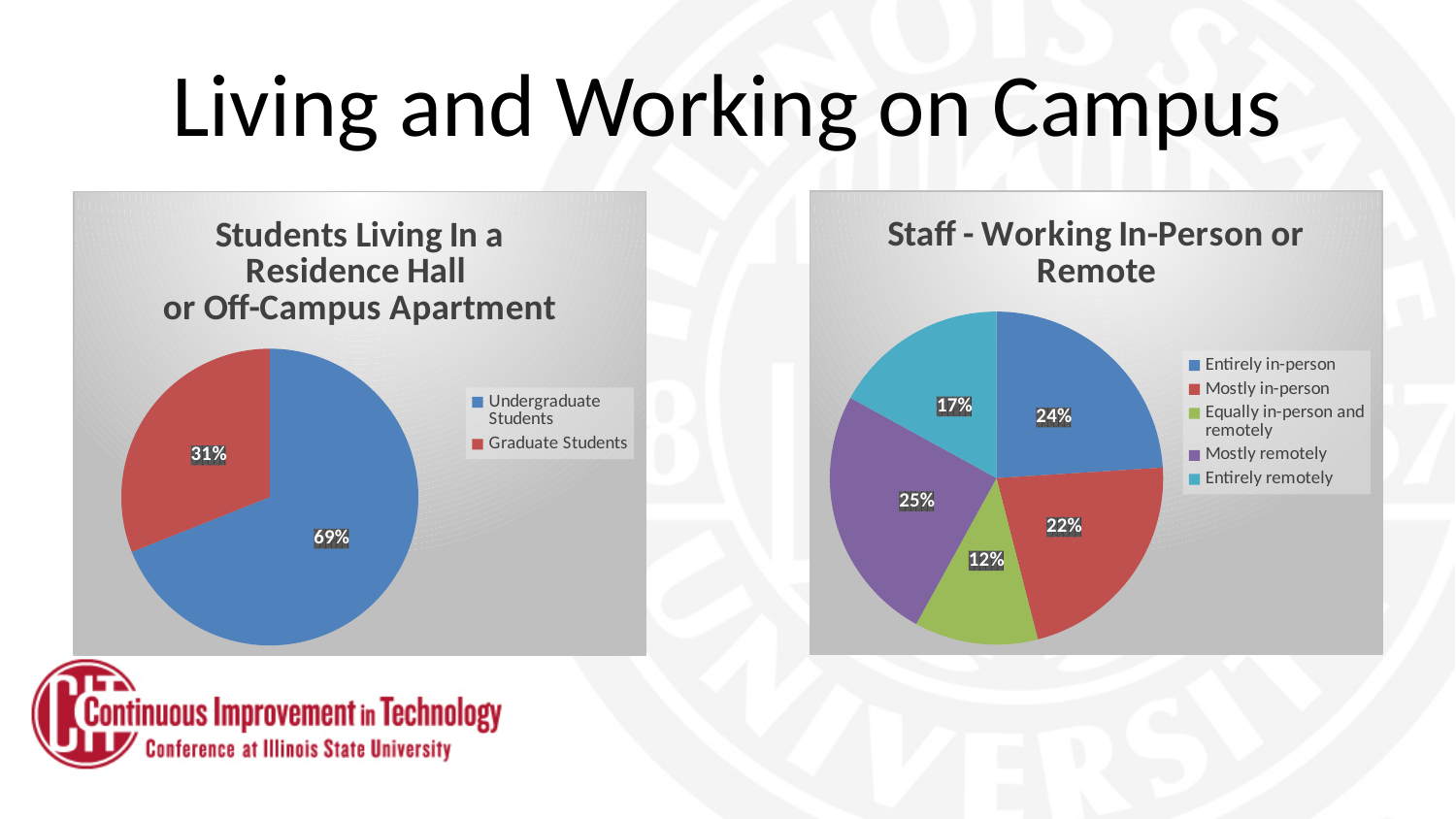
In the 'Staff - Working In-Person or Remote' chart, what percentage of staff work Equally in-person and remotely? 12% In the 'Staff - Working In-Person or Remote' chart, what percentage of staff work Mostly remotely? 25% In the 'Students Living In a Residence Hall or Off-Campus Apartment' chart, what percentage is shown for Undergraduate Students? 69% In the 'Staff - Working In-Person or Remote' chart, which category has the largest share? Mostly remotely What kind of chart is the 'Students Living In a Residence Hall or Off-Campus Apartment' chart? Pie chart In the 'Students Living In a Residence Hall or Off-Campus Apartment' chart, what is the difference between the Undergraduate Students and Graduate Students percentages? 38% In the 'Staff - Working In-Person or Remote' chart, what percentage of staff work Entirely in-person? 24% In the 'Staff - Working In-Person or Remote' chart, how many categories does the legend list? 5 In the 'Staff - Working In-Person or Remote' chart, what is the difference between the Mostly in-person and Entirely remotely percentages? 5% How many categories does the legend of the 'Students Living In a Residence Hall or Off-Campus Apartment' chart list? 2 In the 'Staff - Working In-Person or Remote' chart, which category has the smallest share? Equally in-person and remotely In the 'Students Living In a Residence Hall or Off-Campus Apartment' chart, what percentage is shown for Graduate Students? 31%